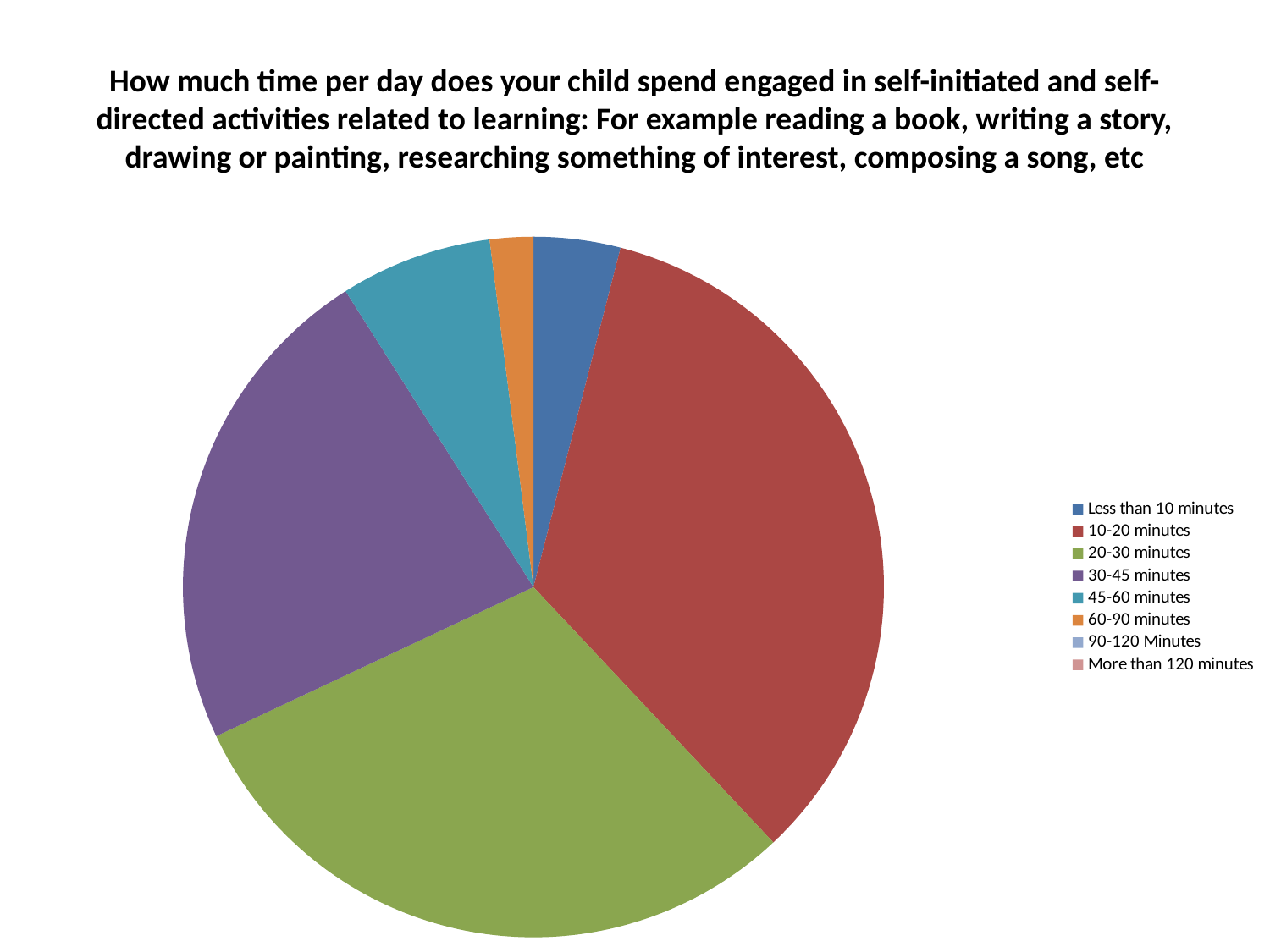
Which slice is larger: Less than 10 minutes or 60-90 minutes? Less than 10 minutes What kind of chart is shown on the slide? pie chart Which slice is larger: 20-30 minutes or 45-60 minutes? 20-30 minutes Which category has the largest slice of the pie? 10-20 minutes What colour is the slice for 20-30 minutes? green Which slice is larger: 30-45 minutes or 45-60 minutes? 30-45 minutes Which legend entry is listed first? Less than 10 minutes How many entries does the legend list? 8